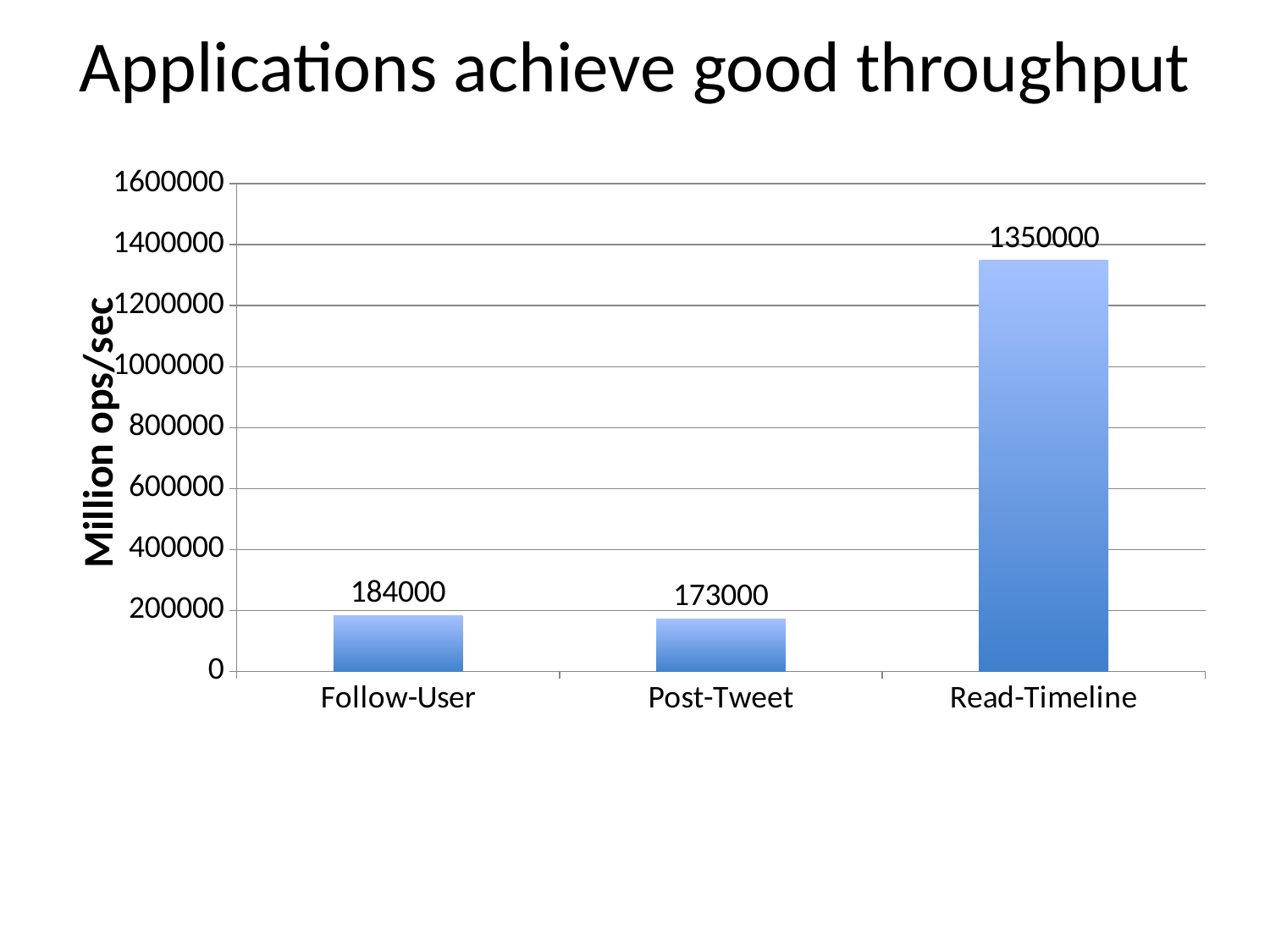
What is the difference between the values for Read-Timeline and Follow-User? 1166000 What kind of chart is shown on the slide? bar chart Which is larger, the value for Follow-User or the value for Post-Tweet? Follow-User How many categories are shown on the x axis? 3 What is the value for Post-Tweet? 173000 Which category has the lowest value? Post-Tweet Which category has the highest value? Read-Timeline Is the value for Read-Timeline greater or less than 1200000? greater What is the value for Follow-User? 184000 What is the label of the y axis? Million ops/sec What is the value for Read-Timeline? 1350000 What is the difference between the values for Follow-User and Post-Tweet? 11000